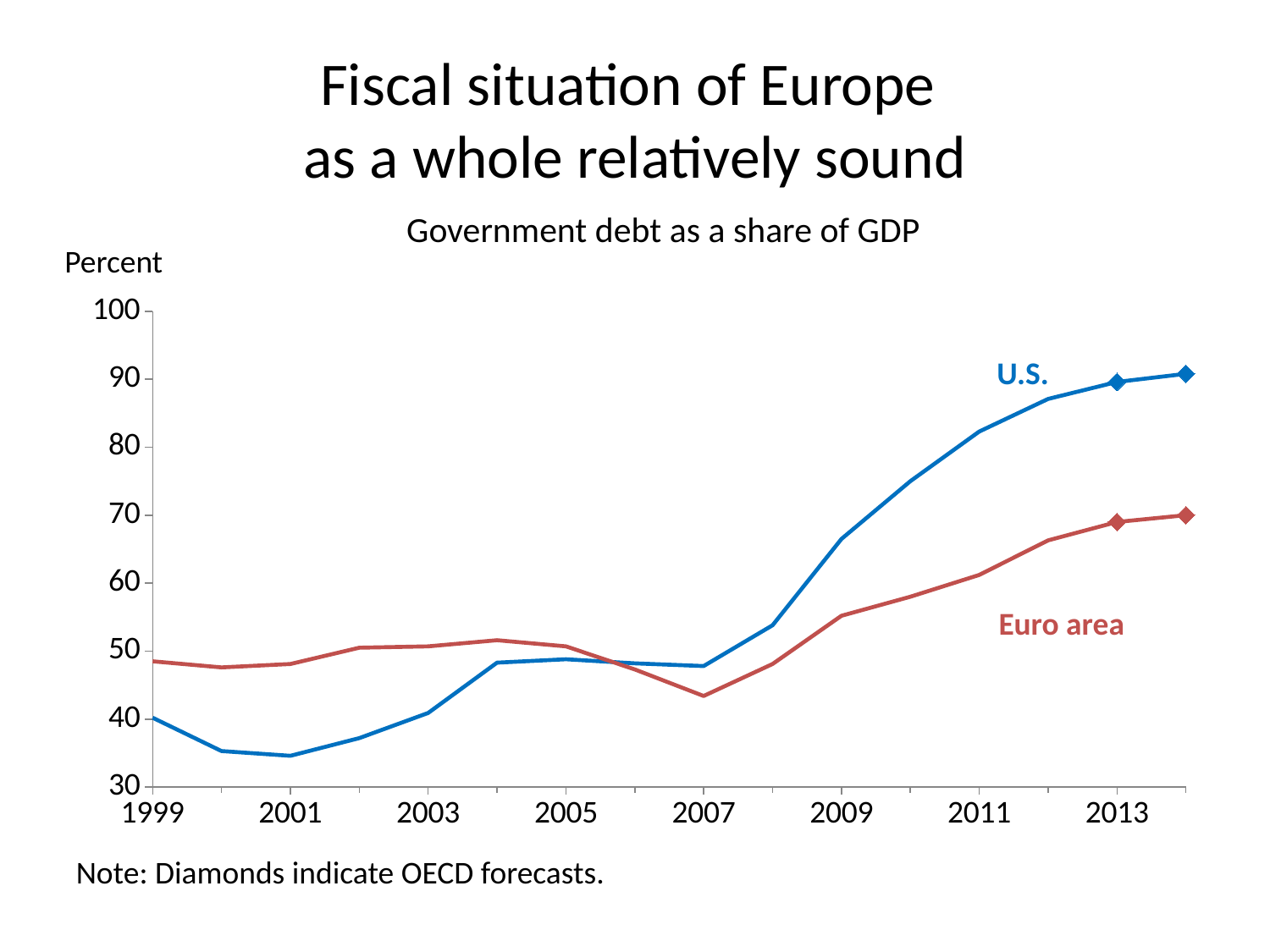
Is the value for the U.S. in 2009 greater or less than 60? greater What does the chart's subtitle say is being plotted? Government debt as a share of GDP Is the value for the Euro area in 2007 greater or less than 50? less In 1999, which series has the higher value, U.S. or Euro area? Euro area How many series are plotted on the chart? 2 Is the value for the U.S. in 2013 greater or less than 80? greater What kind of chart is shown on the slide? line chart In 2013, which series has the higher value, U.S. or Euro area? U.S. Which two series are labelled on the chart? U.S. and Euro area